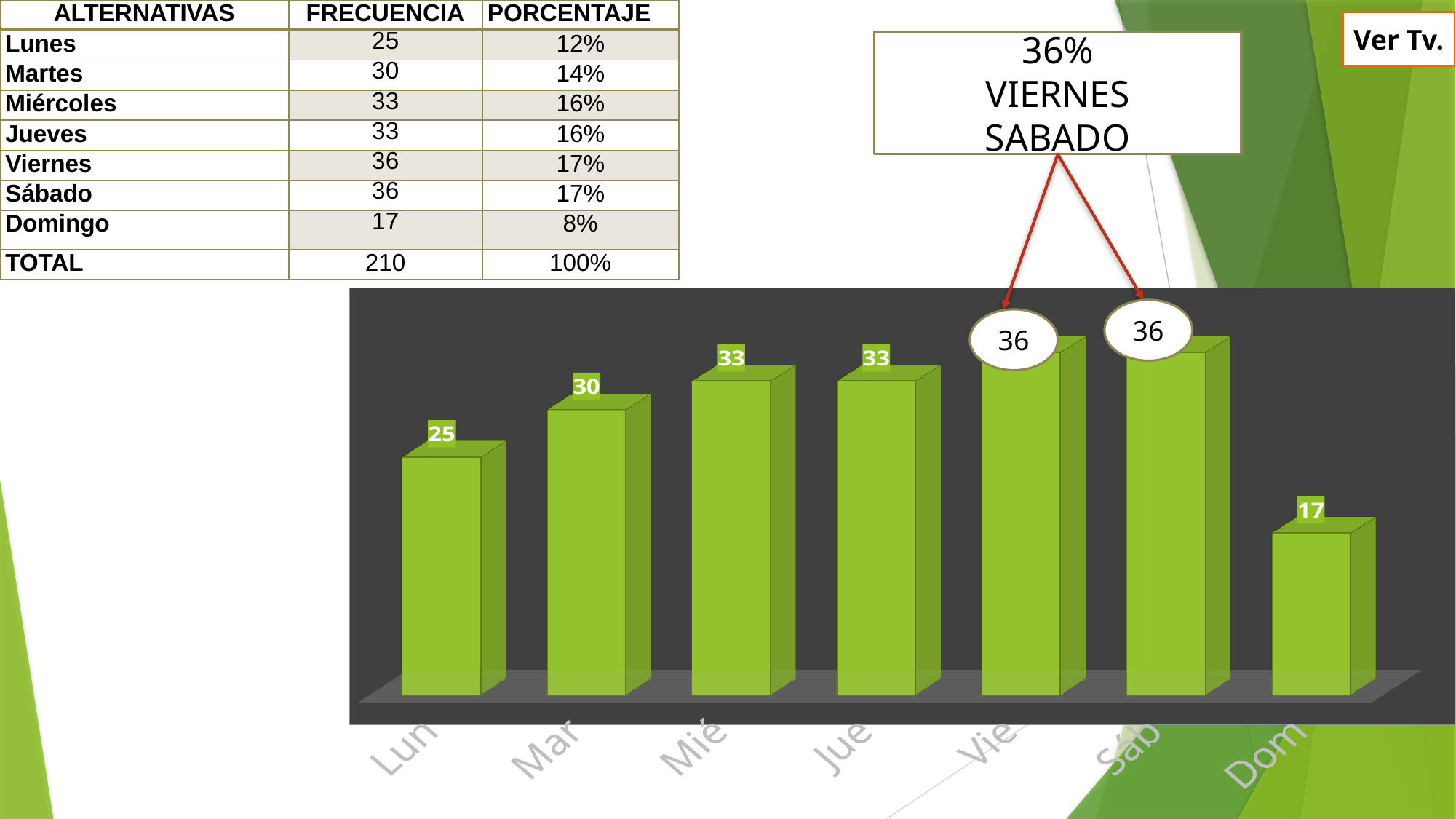
What is the difference between the values for Vie and Dom? 19 What is the value for Jue in the bar chart? 33 What is the difference between the values for Mar and Lun? 5 Which category has the lowest value in the bar chart? Dom Which is larger, the value for Mié or the value for Mar? Mié What kind of chart is shown on the slide? bar chart Which is larger, the value for Lun or the value for Dom? Lun What is the value for Mar in the bar chart? 30 What is the value for Dom in the bar chart? 17 What is the value for Lun in the bar chart? 25 What colour are the bars in the chart? green How many categories are shown in the bar chart? 7